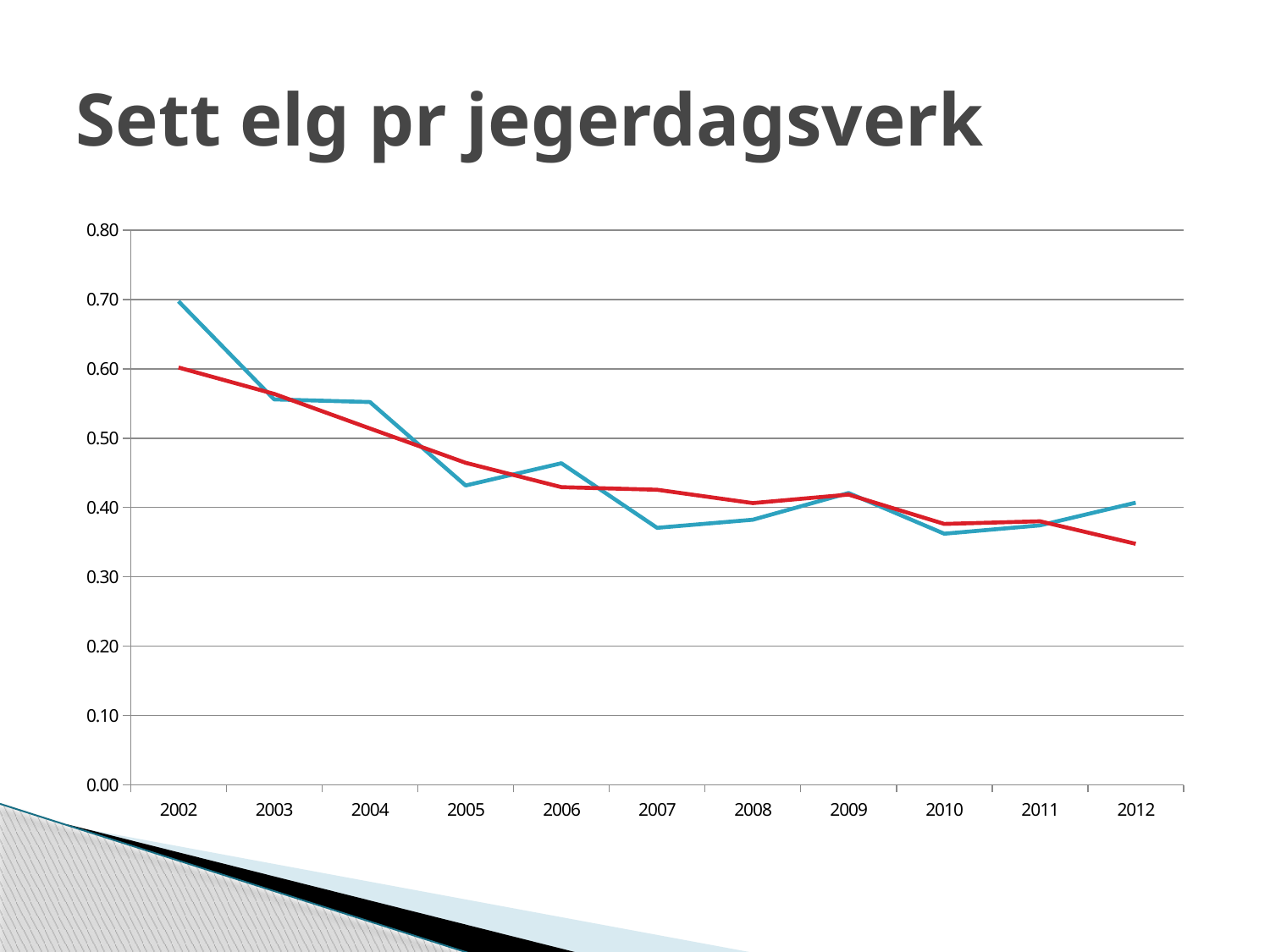
How many years are shown on the x axis of the chart? 11 What kind of chart is shown on the slide? line chart Is the value of the red line in 2012 greater or less than 0.40? less What is the title of the chart? Sett elg pr jegerdagsverk In which year is the blue line at its highest value? 2002 Is the value of the blue line in 2007 greater or less than 0.40? less In 2007, which line has the higher value, the blue line or the red line? the red line Is the value of the blue line in 2002 greater or less than 0.60? greater Do the values of the blue line generally rise or fall from 2002 to 2012? fall How many lines are plotted on the chart? 2 In which year is the red line at its lowest value? 2012 In 2002, which line has the higher value, the blue line or the red line? the blue line